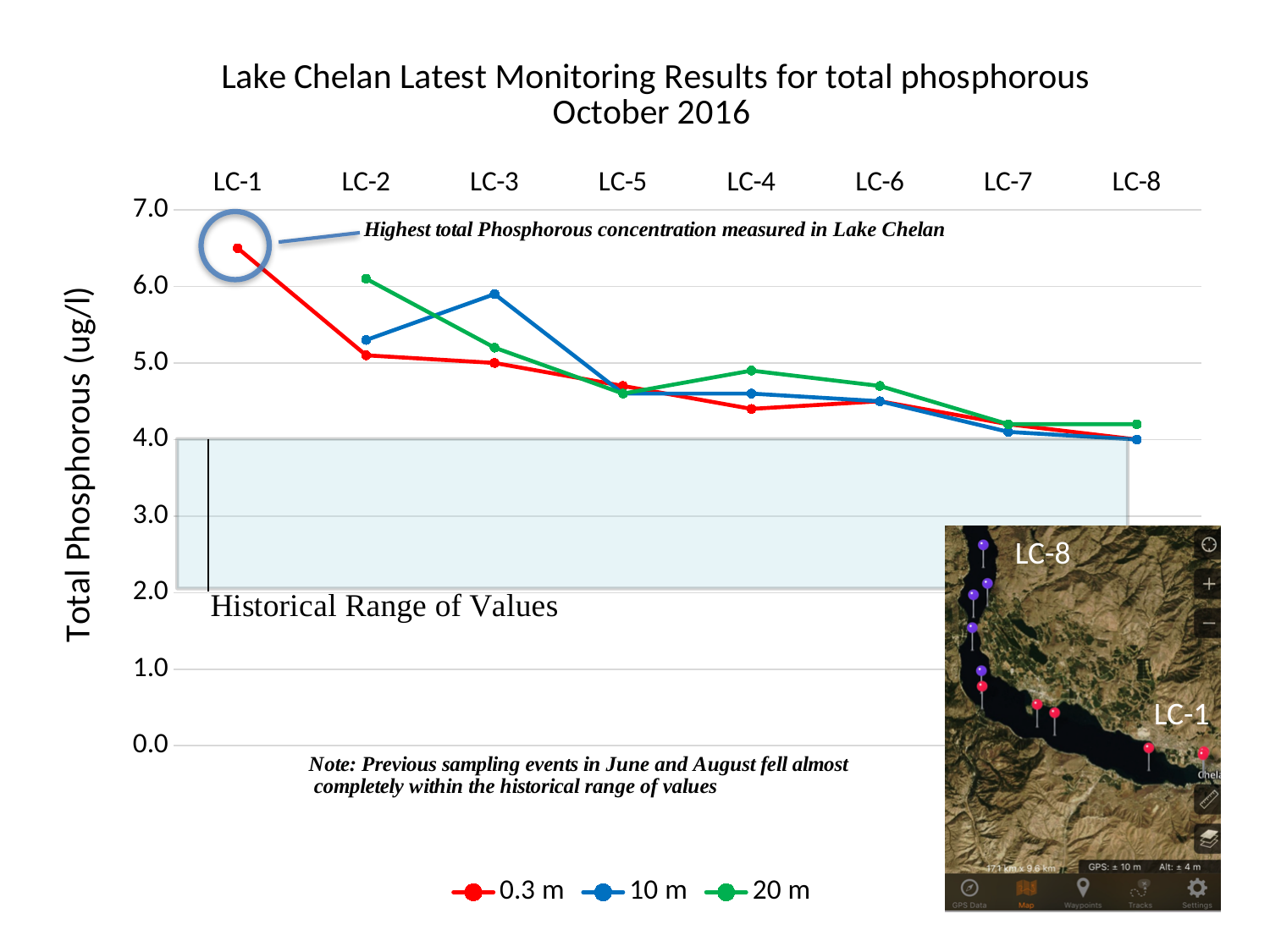
Is the 0.3 m value at LC-1 greater or less than 6.0? greater At which site is the 0.3 m series at its highest value? LC-1 Do the total phosphorous values generally rise or fall from LC-1 to LC-8? Fall How many series does the legend list? 3 Which series has the highest total phosphorous value on the chart, and at which site? 0.3 m at LC-1 Is the 20 m value at LC-6 greater or less than 5.0? less At LC-3, which series has the larger value, 10 m or 0.3 m? 10 m What kind of chart is shown on the slide? Line chart Is the 0.3 m value at LC-4 greater or less than 5.0? less What is the label of the vertical axis? Total Phosphorous (ug/l) How many sampling sites (categories) are plotted along the x axis? 8